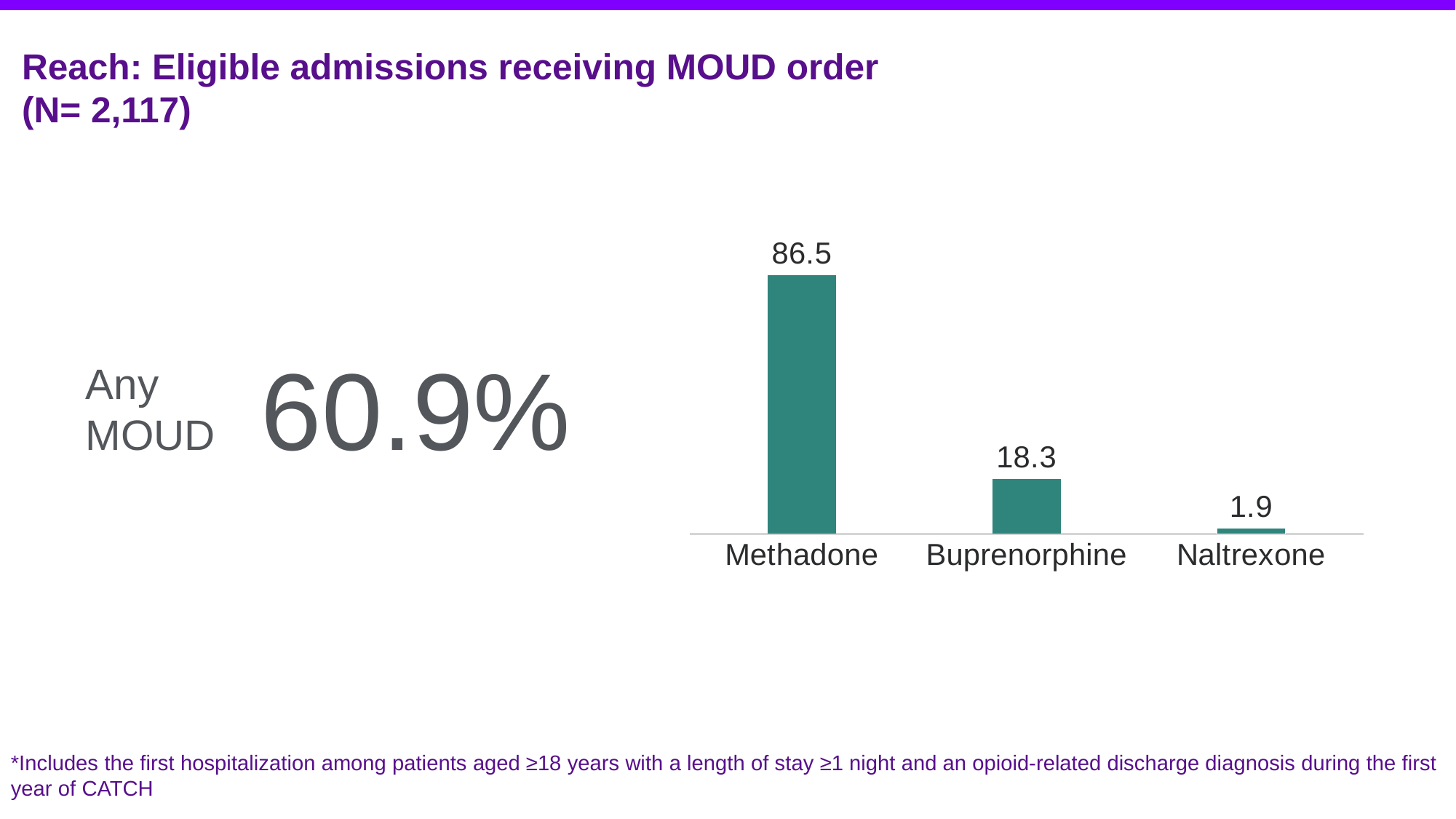
What is the value for Naltrexone? 1.9 How many categories are shown in the chart? 3 What is the difference between the values for Methadone and Buprenorphine? 68.2 What is the value for Methadone? 86.5 What is the value for Buprenorphine? 18.3 Do the values rise or fall from left to right across the categories? Fall Which is larger, the value for Buprenorphine or the value for Naltrexone? Buprenorphine What percentage is shown for Any MOUD on the slide? 60.9% Which category has the highest value? Methadone What kind of chart is shown on the slide? Bar chart Which category has the lowest value? Naltrexone What is the difference between the values for Buprenorphine and Naltrexone? 16.4